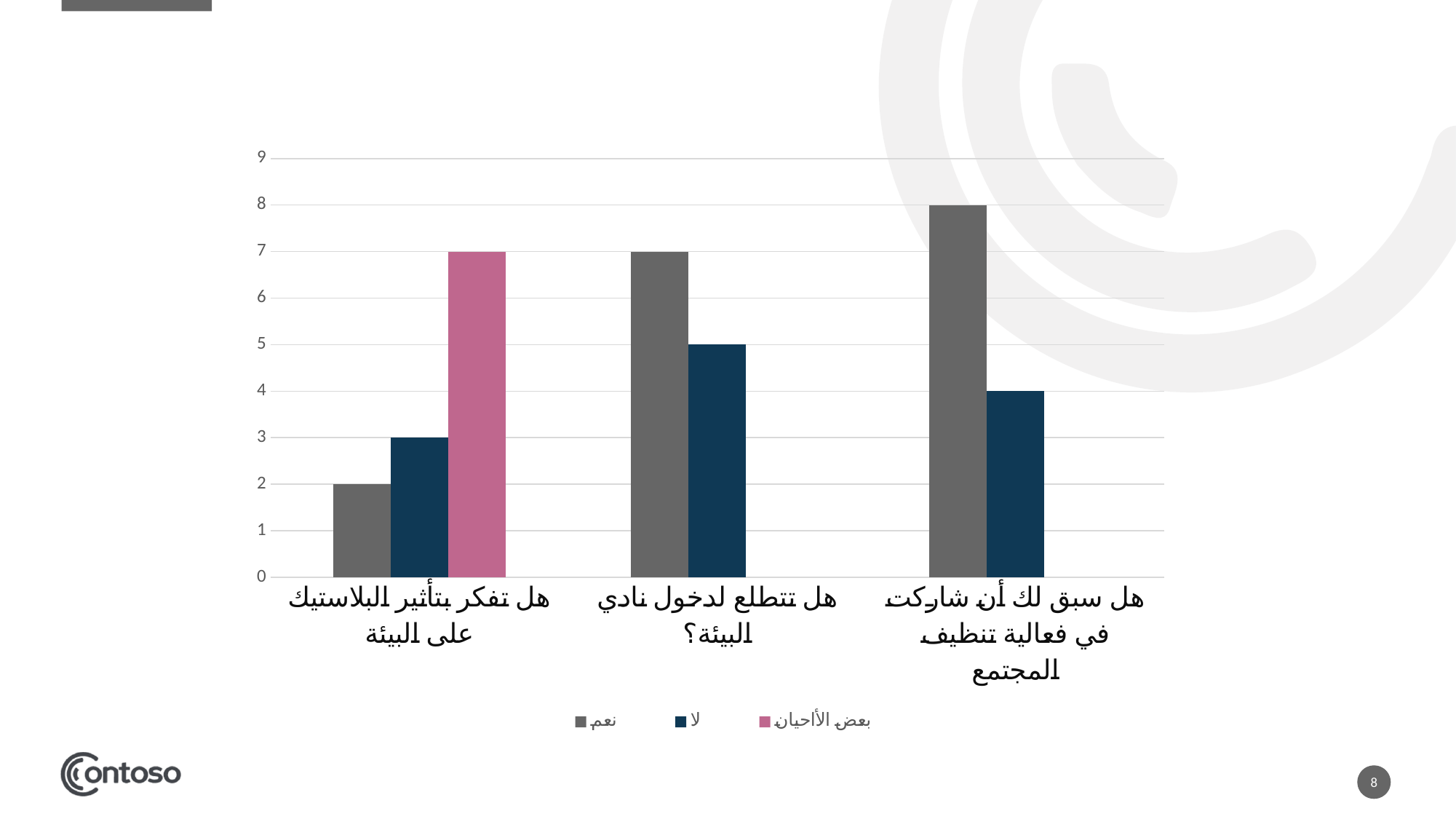
For هل تفكر بتأثير البلاستيك على البيئة, which is larger: the نعم bar or the لا bar? لا What is the value of the لا bar for هل تتطلع لدخول نادي البيئة؟? 5 What is the value of the بعض الأحيان bar for هل تفكر بتأثير البلاستيك على البيئة? 7 Which category has the highest نعم value? هل سبق لك أن شاركت في فعالية تنظيف المجتمع What kind of chart is shown on the slide? bar chart How many categories are shown on the x axis? 3 Is the نعم value for هل تتطلع لدخول نادي البيئة؟ greater or less than 5? greater How many series does the legend list? 3 Which category has the lowest نعم value? هل تفكر بتأثير البلاستيك على البيئة Which series is shown in pink in the legend? بعض الأحيان What is the difference between the نعم and لا values for هل سبق لك أن شاركت في فعالية تنظيف المجتمع? 4 What is the value of the نعم bar for هل سبق لك أن شاركت في فعالية تنظيف المجتمع? 8